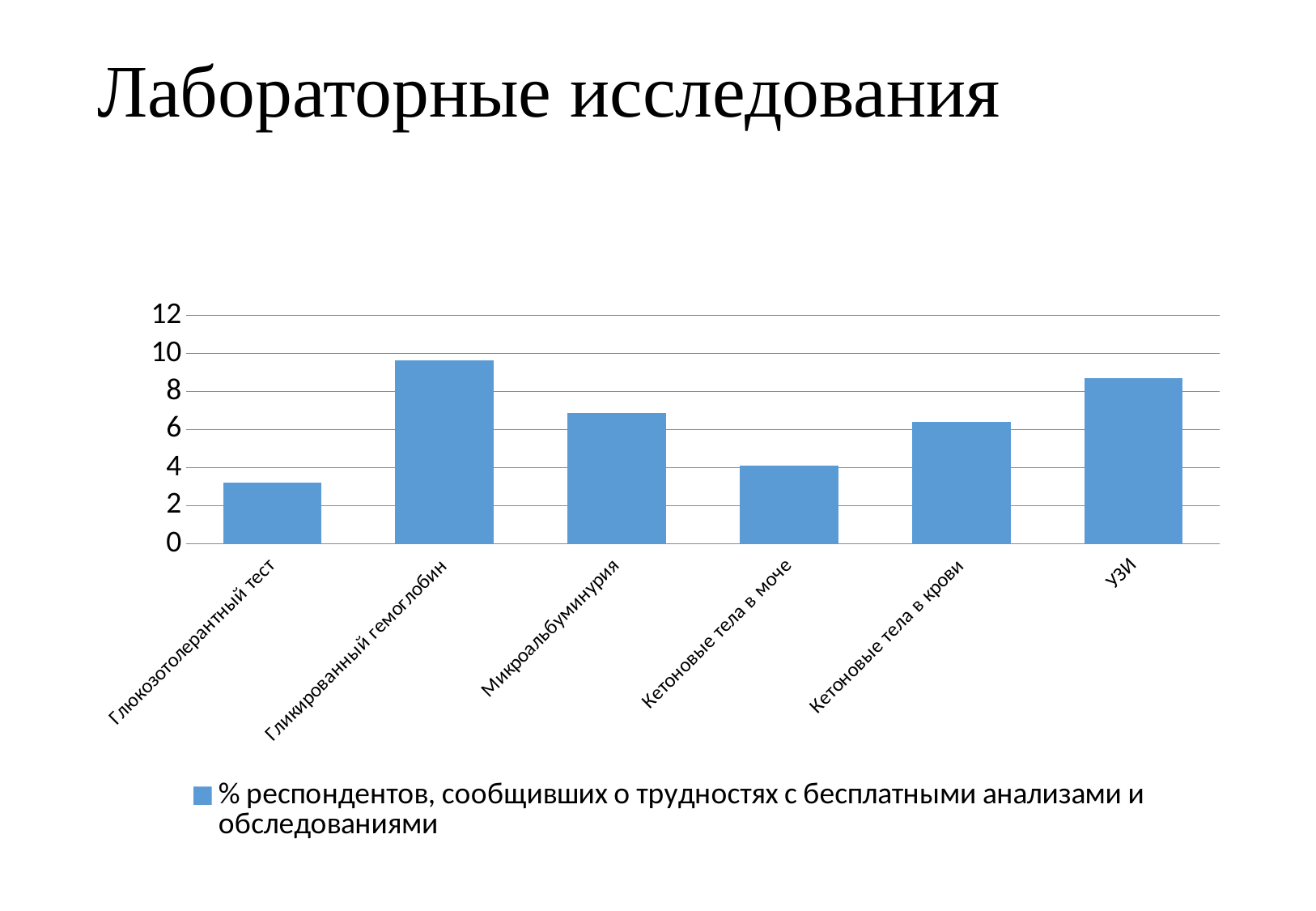
Is the value for Глюкозотолерантный тест greater or less than 4? less How many series does the legend list? 1 Which category has the lowest value? Глюкозотолерантный тест Which category has the highest value? Гликированный гемоглобин Is the value for Гликированный гемоглобин greater or less than 8? greater Is the value for Кетоновые тела в моче greater or less than 6? less Which is larger, the value for УЗИ or the value for Микроальбуминурия? УЗИ How many categories are plotted on the chart? 6 What kind of chart is shown on the slide? bar chart What is the title of the slide? Лабораторные исследования What is the legend entry for the plotted series? % респондентов, сообщивших о трудностях с бесплатными анализами и обследованиями Which is larger, the value for Гликированный гемоглобин or the value for УЗИ? Гликированный гемоглобин